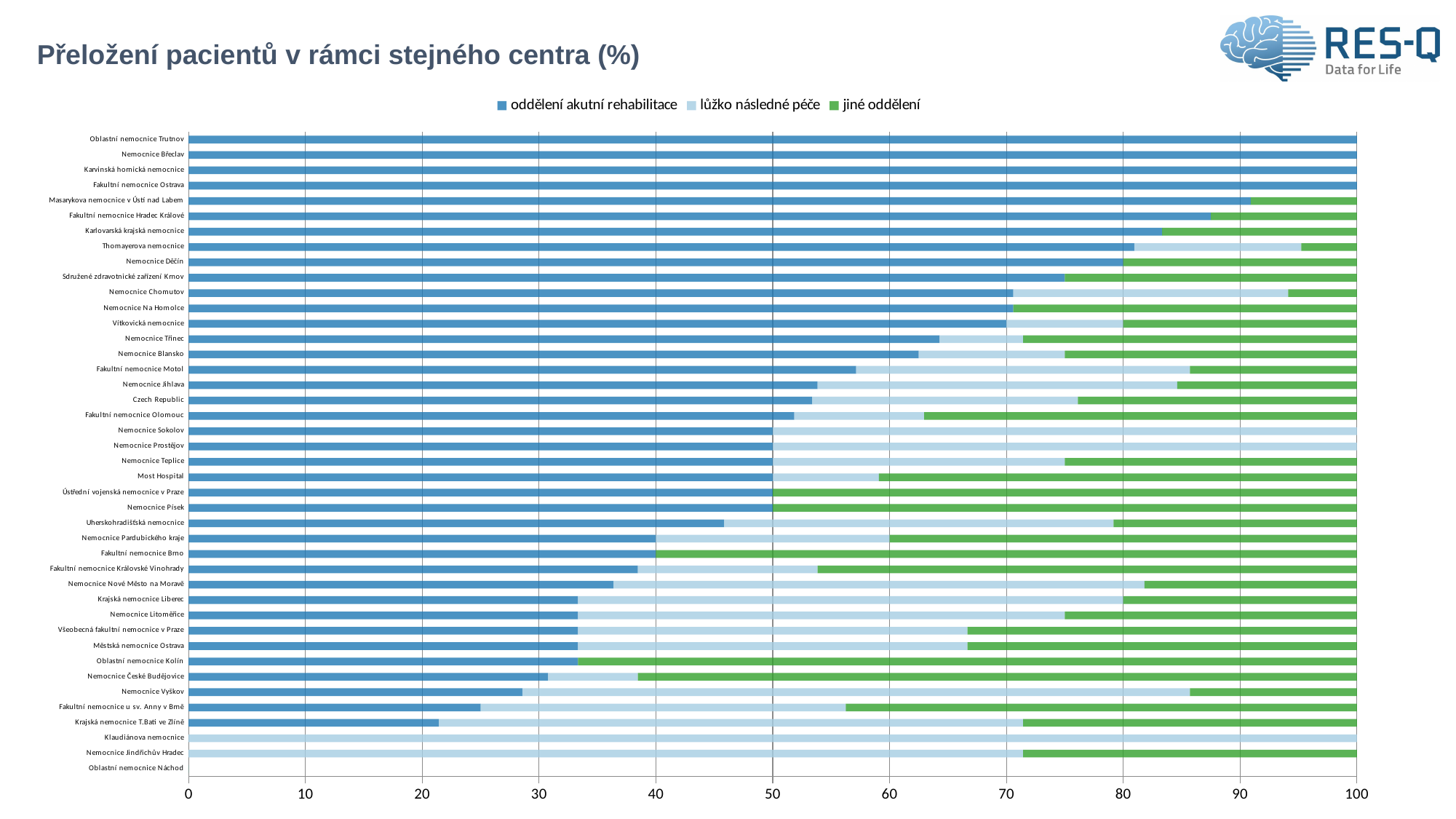
What is the value of 'oddělení akutní rehabilitace' for Nemocnice Pardubického kraje? 40 Which has the larger 'oddělení akutní rehabilitace' value, Nemocnice Jihlava or Nemocnice Vyškov? Nemocnice Jihlava How many hospitals (categories) are listed on the vertical axis? 42 What is the value of 'lůžko následné péče' for Klaudiánova nemocnice? 100 What is the value of 'oddělení akutní rehabilitace' for Nemocnice Sokolov? 50 How many series does the legend list? 3 Is the 'oddělení akutní rehabilitace' value for Fakultní nemocnice Motol greater or less than 50? greater What is the value of 'oddělení akutní rehabilitace' for Nemocnice Děčín? 80 What kind of chart is shown on the slide? Stacked bar chart Is the 'oddělení akutní rehabilitace' value for Krajská nemocnice T.Bati ve Zlíně greater or less than 30? less What is the title of the chart? Přeložení pacientů v rámci stejného centra (%) Is the 'oddělení akutní rehabilitace' value for Uherskohradišťská nemocnice greater or less than 50? less